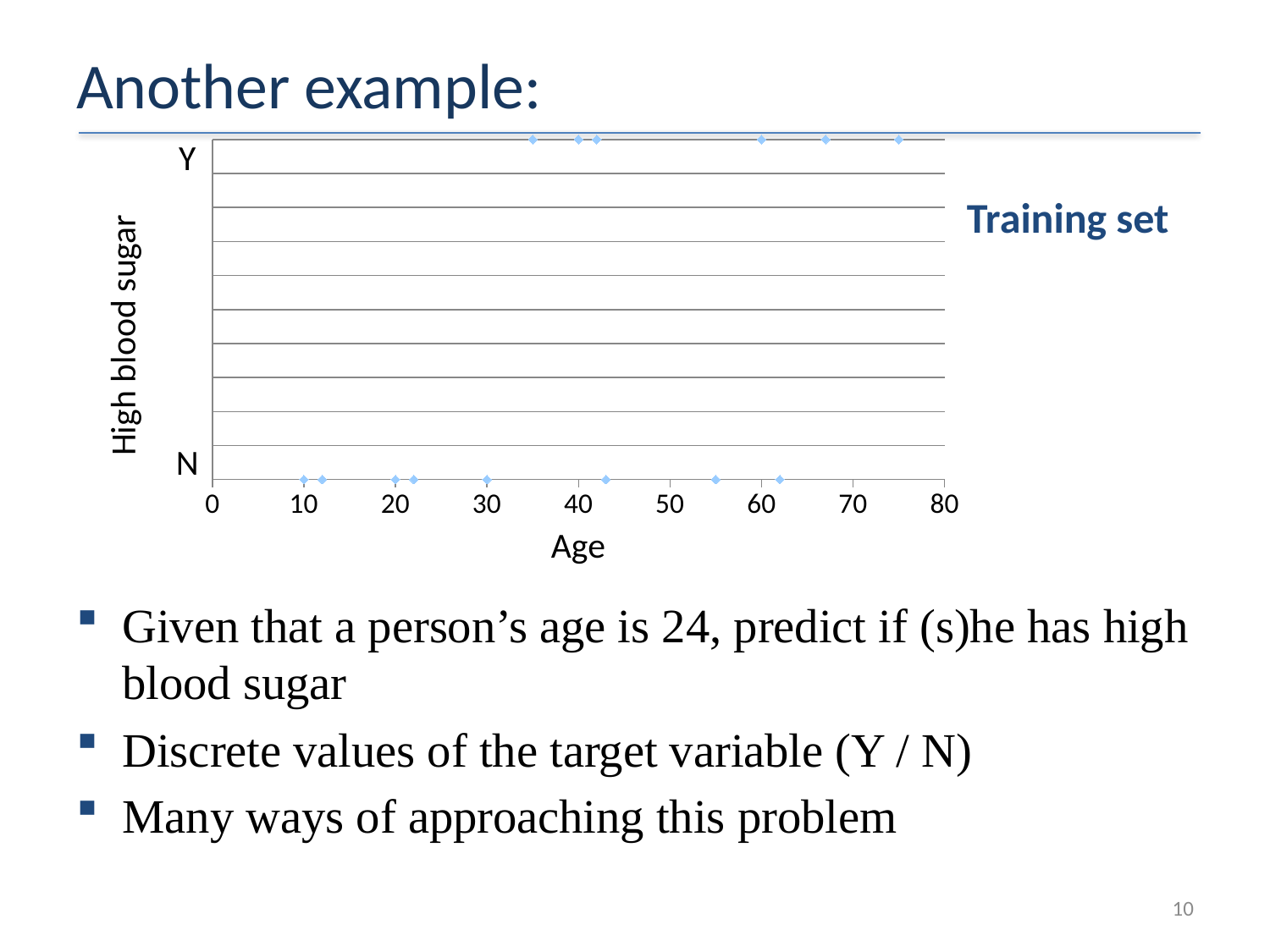
Is the age of the youngest person with high blood sugar Y greater or less than 30? greater What high blood sugar value does the leftmost (youngest) point in the chart have? N What is the label of the x axis of the chart? Age How many data points are plotted in the chart in total? 14 Are there more points at the Y level or at the N level? N Is the age of the oldest person in the training set greater or less than 70? greater How many data points are plotted at the Y level of the chart? 6 How many data points are plotted at the N level of the chart? 8 What high blood sugar value does the rightmost (oldest) point in the chart have? Y What kind of chart is shown on the slide? scatter chart What is the label of the y axis of the chart? High blood sugar Is the age of the oldest person with high blood sugar N greater or less than 70? less